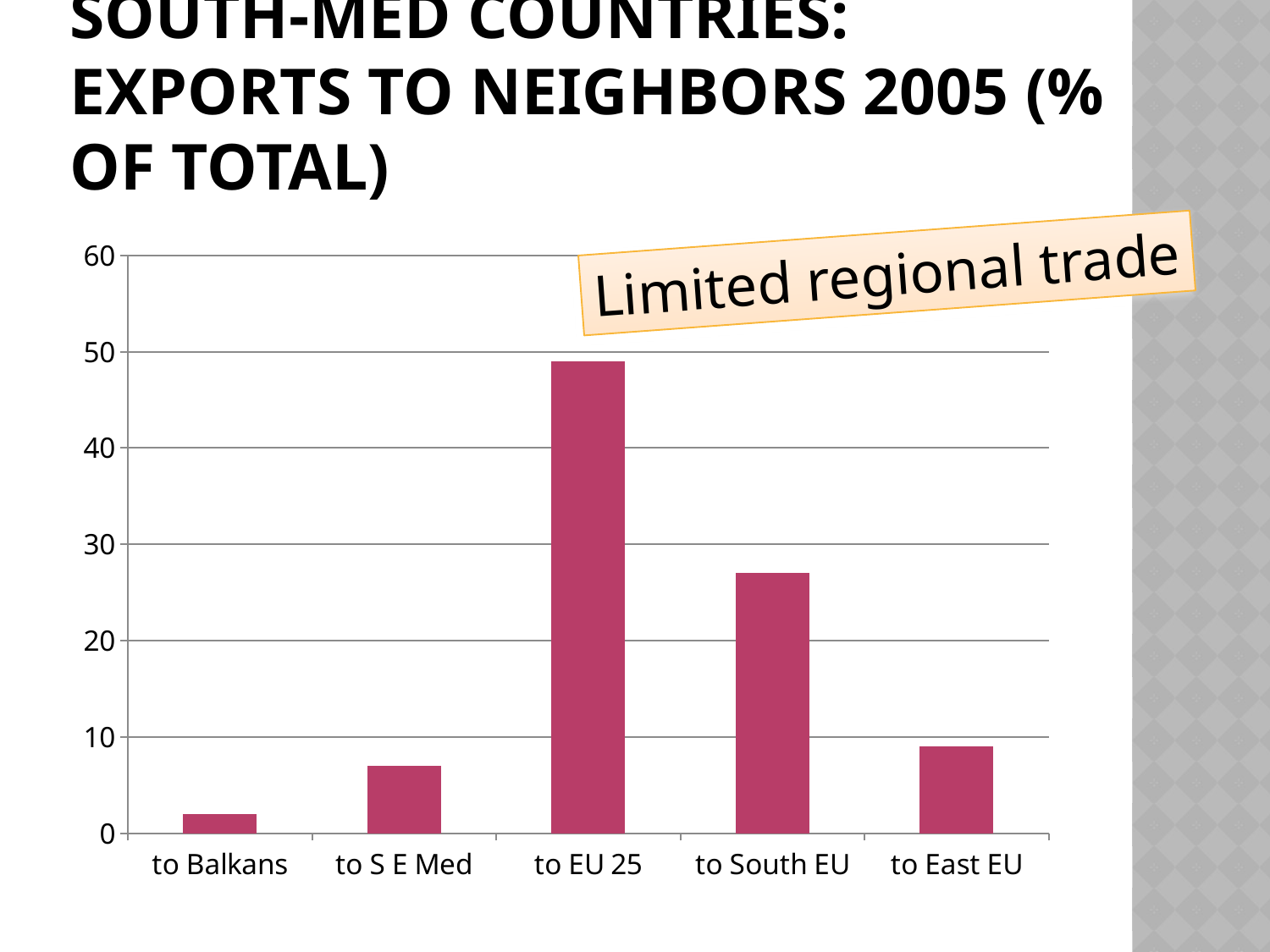
Which category has the lowest value in the chart? to Balkans What text appears in the callout box overlaid on the chart? Limited regional trade Which is larger, the value for to S E Med or the value for to Balkans? to S E Med Is the value for to Balkans greater or less than 10? less Is the value for to S E Med greater or less than 10? less What kind of chart is shown on the slide? bar chart Is the value for to South EU greater or less than 20? greater Which is larger, the value for to South EU or the value for to East EU? to South EU How many categories are shown on the x axis of the chart? 5 Which category has the highest value in the chart? to EU 25